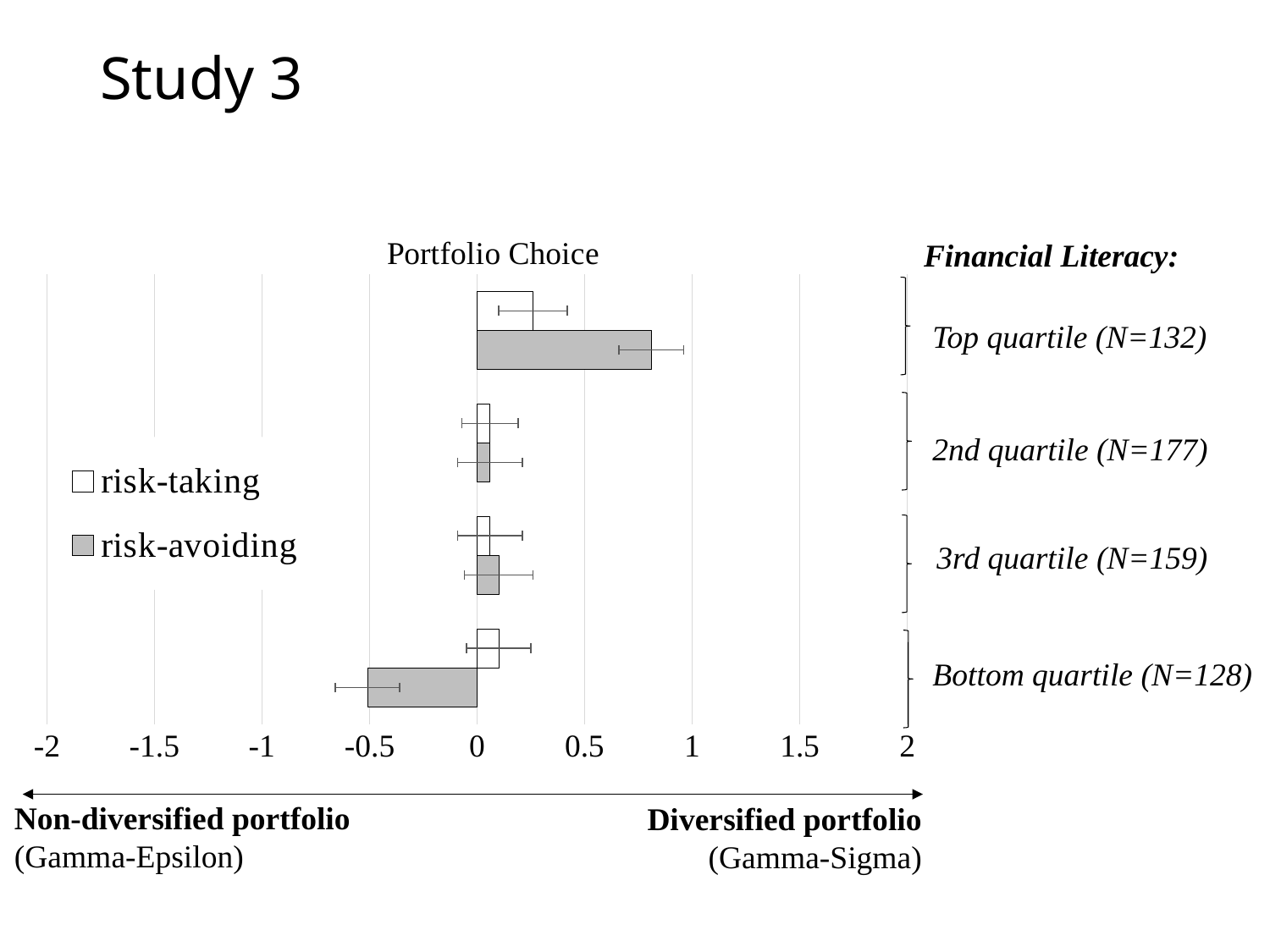
Is the risk-avoiding value for the Bottom quartile greater or less than -1? greater What is the title of the chart? Portfolio Choice What kind of chart is shown on the slide? bar chart Is the risk-taking value for the Top quartile greater or less than 0.5? less For the Top quartile, which series has the larger value, risk-taking or risk-avoiding? risk-avoiding How many financial literacy quartile categories are plotted? 4 Is the risk-avoiding value for the Bottom quartile greater or less than 0? less Which category has the lowest risk-avoiding value? Bottom quartile (N=128) Which category has the highest risk-avoiding value? Top quartile (N=132) How many series does the legend list? 2 For the Bottom quartile, which series has the larger value, risk-taking or risk-avoiding? risk-taking